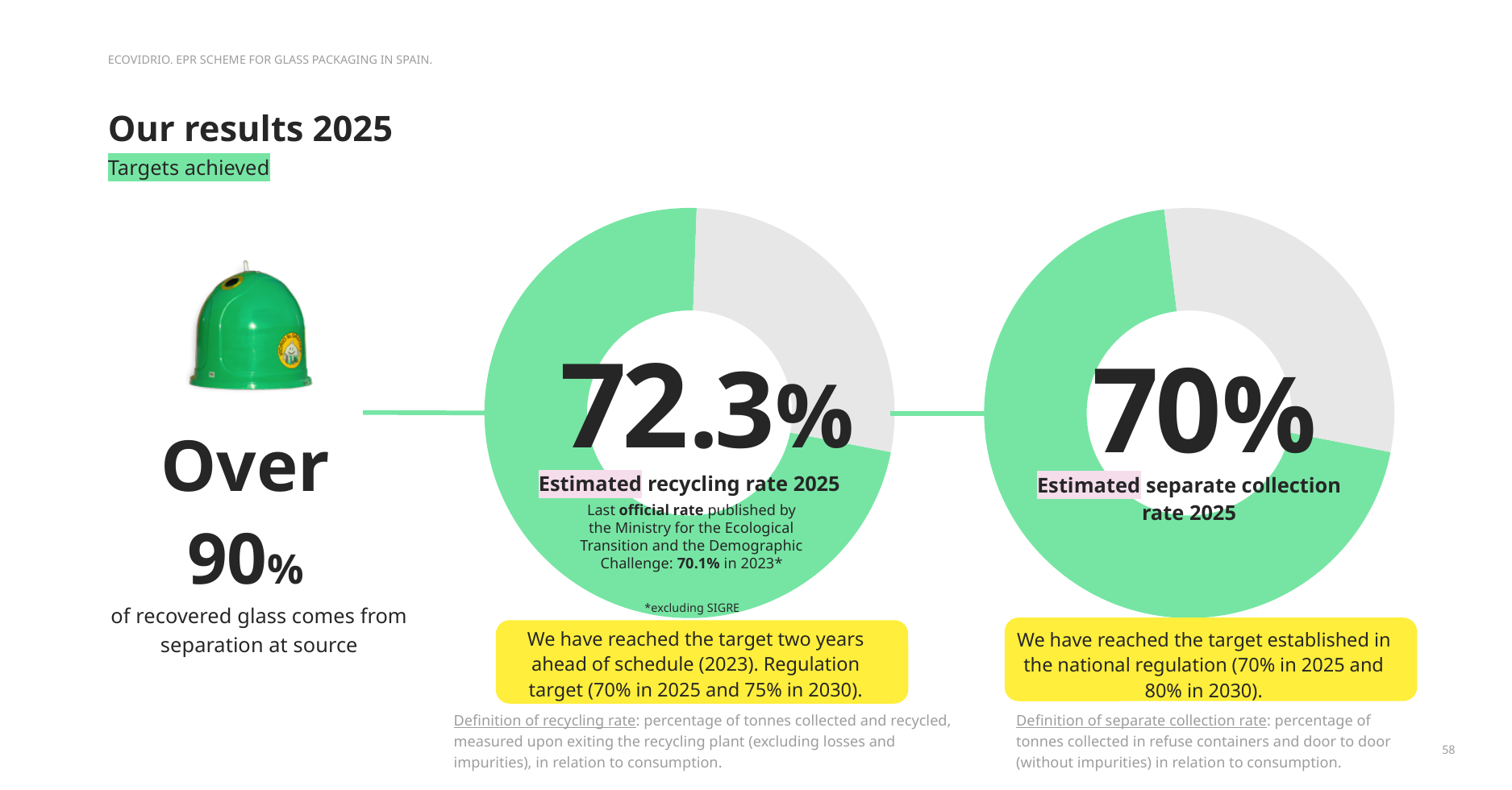
What is the title of the slide containing the two donut charts? Our results 2025 How many donut charts are shown on the slide? 2 Is the value shown in the 'Estimated separate collection rate 2025' chart greater or less than 50%? greater What value is shown in the centre of the 'Estimated separate collection rate 2025' donut chart? 70% What kind of chart is used to show the estimated recycling rate 2025? Donut (pie) chart What value is shown in the centre of the 'Estimated recycling rate 2025' donut chart? 72.3% By how many percentage points does the estimated recycling rate 2025 exceed the estimated separate collection rate 2025? 2.3 In the 'Estimated separate collection rate 2025' chart, what share of the donut is filled green? 70% Which is larger, the estimated recycling rate 2025 or the estimated separate collection rate 2025? Estimated recycling rate 2025 What colour represents the achieved portion in both donut charts? Green